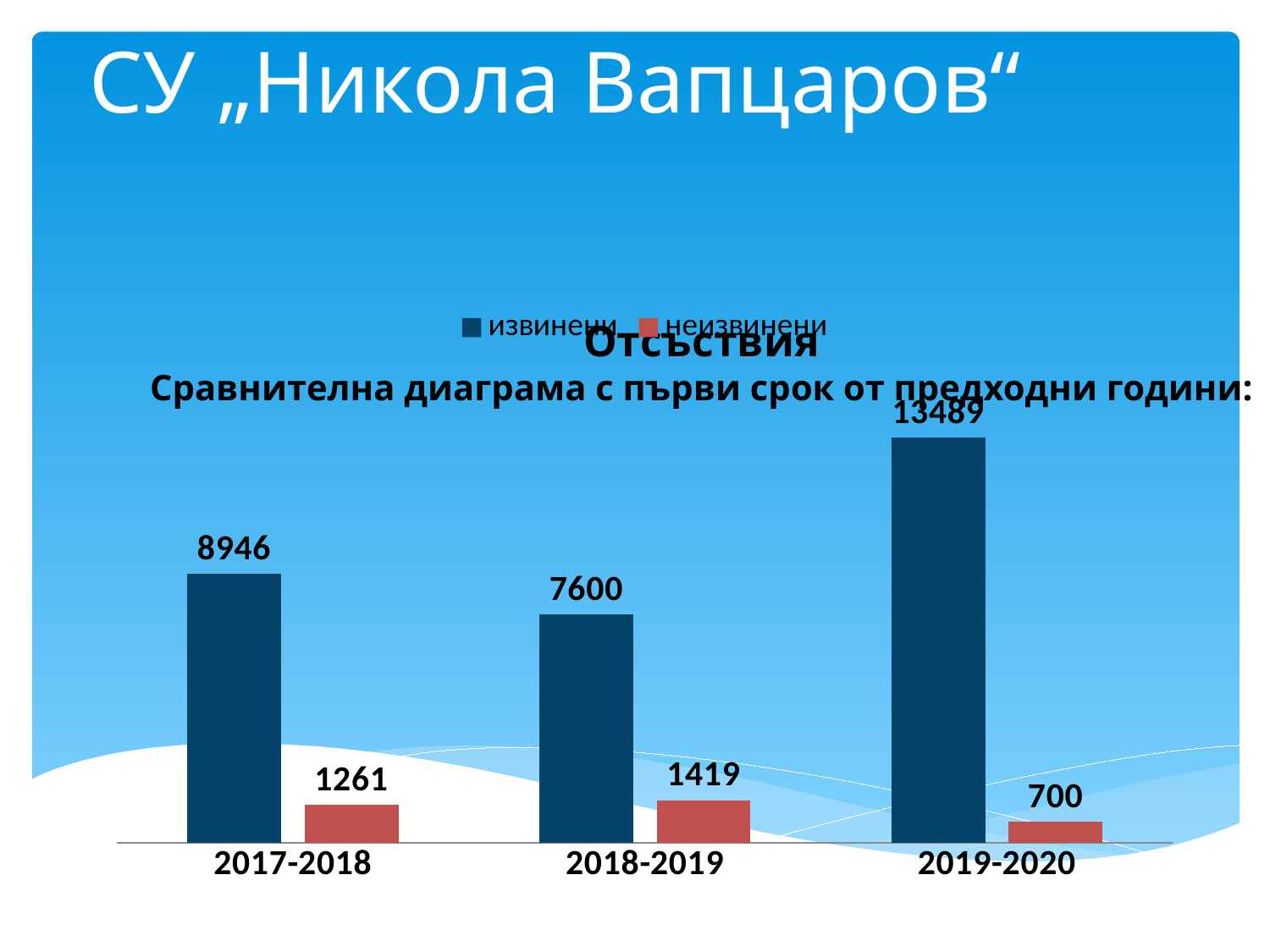
What is the value for извинени in 2019-2020? 13489 Which school year has the lowest value for неизвинени? 2019-2020 What kind of chart is shown on the slide? bar chart Which is larger: неизвинени in 2017-2018 or неизвинени in 2018-2019? неизвинени in 2018-2019 What is the difference between извинени and неизвинени in 2017-2018? 7685 What is the value for неизвинени in 2018-2019? 1419 Which school year has the highest value for извинени? 2019-2020 What is the title of the chart? Отсъствия What is the value for извинени in 2017-2018? 8946 How many school years are shown on the x axis? 3 What is the difference between извинени in 2019-2020 and извинени in 2018-2019? 5889 How many series does the legend list? 2